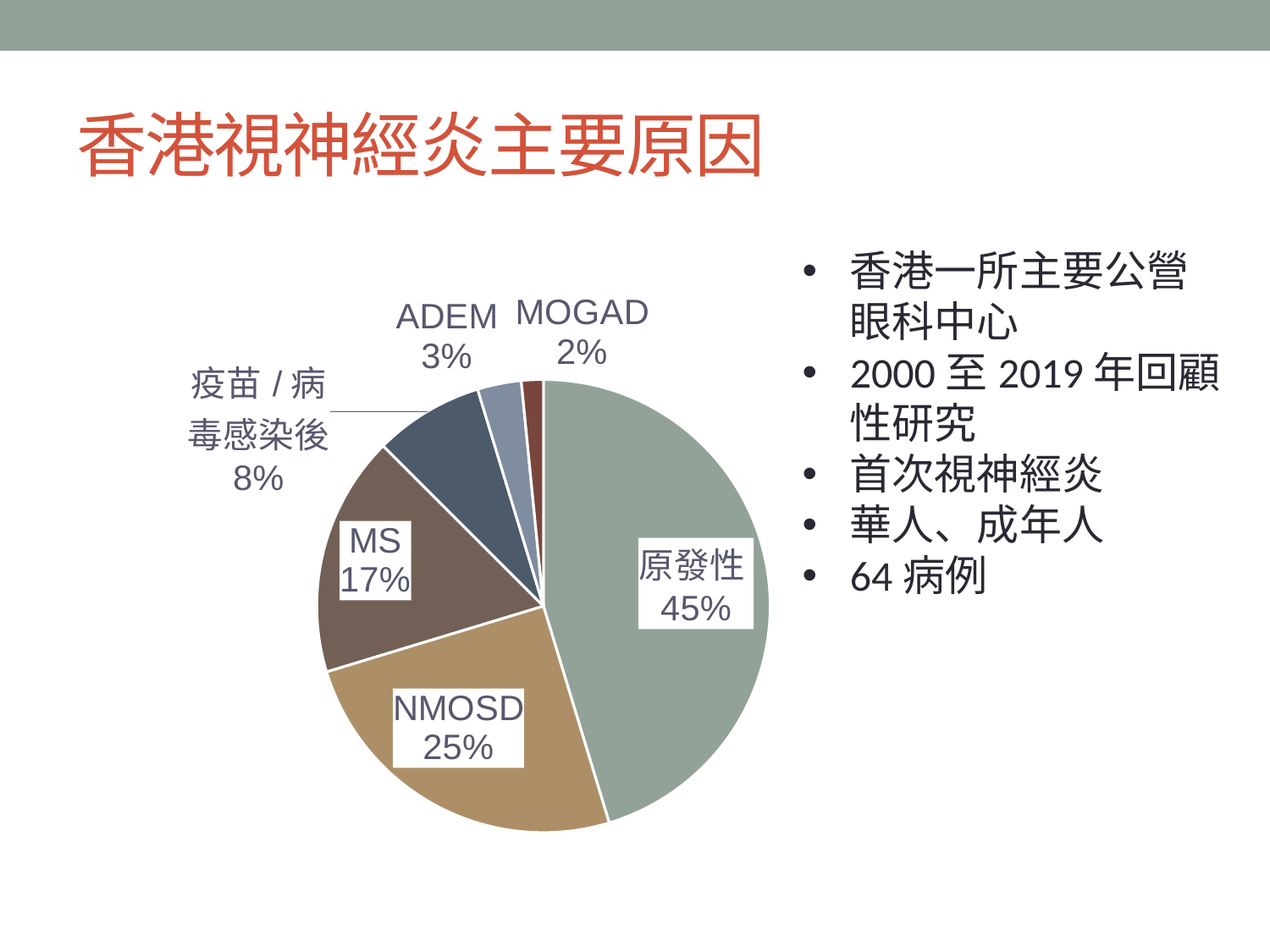
What percentage of the pie is labelled 原發性? 45% Which slice is larger, MS or ADEM? MS What is the difference in percentage points between the 原發性 slice and the NMOSD slice? 20 Which slice of the pie is the largest? 原發性 What percentage of the pie is labelled MOGAD? 2% What is the title of the slide containing the pie chart? 香港視神經炎主要原因 Which slice of the pie is the smallest? MOGAD What kind of chart is shown on the slide? pie chart What percentage of the pie is labelled NMOSD? 25% What percentage of the pie is labelled 疫苗 / 病毒感染後? 8% How many slices does the pie chart have? 6 What percentage of the pie is labelled MS? 17%